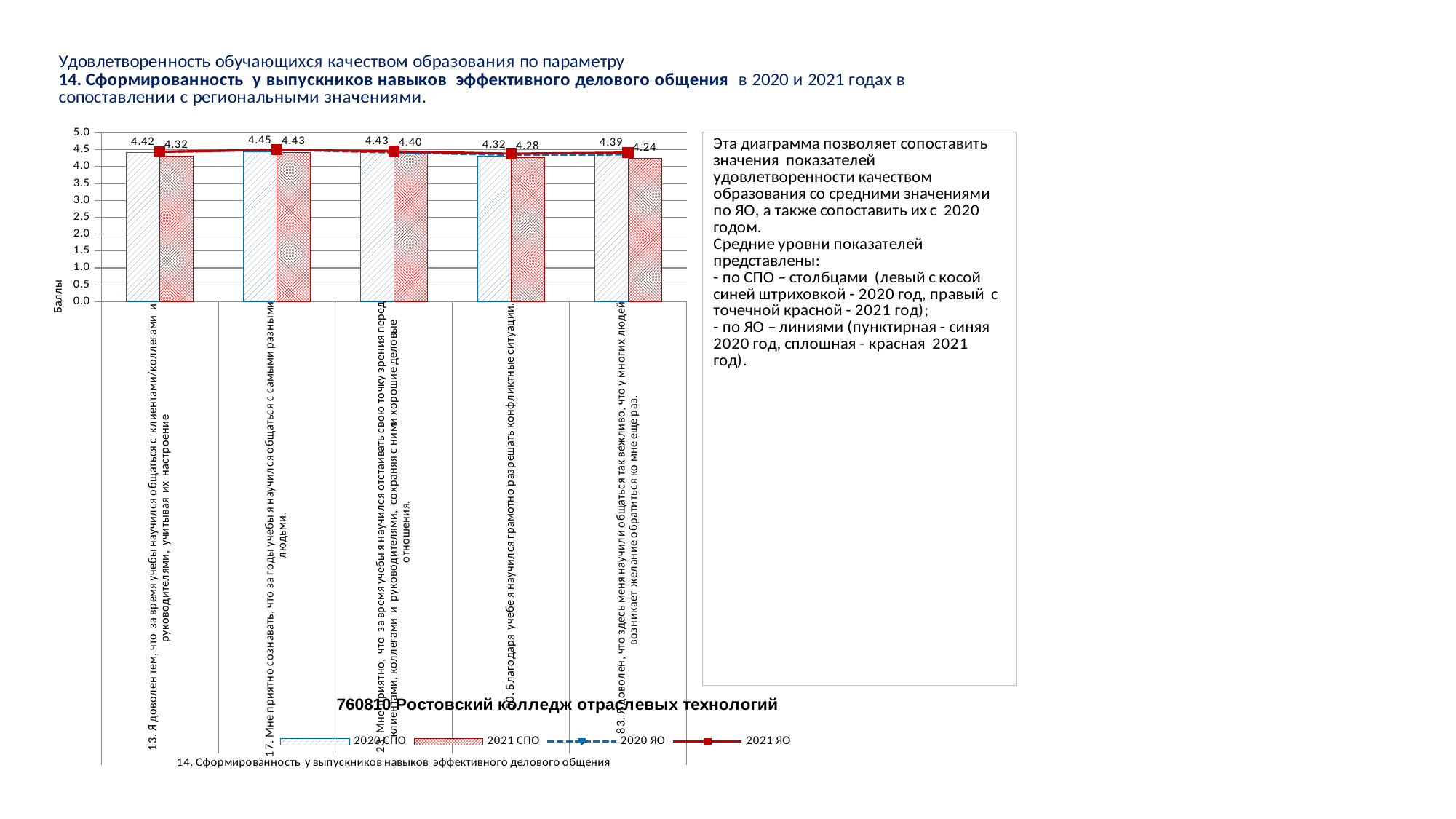
What is the 2021 СПО value for item 83 (Я доволен, что здесь меня научили общаться так вежливо)? 4.24 For item 13, which is larger: the 2020 СПО value or the 2021 СПО value? 2020 СПО Which item has the lowest 2021 СПО value? 83. Я доволен, что здесь меня научили общаться так вежливо, что у многих людей возникает желание обратиться ко мне еще раз How many series does the chart legend list? 4 What kind of chart is shown on the slide? Bar chart with lines What is the 2021 СПО value for item 50 (Благодаря учебе я научился грамотно разрешать конфликтные ситуации)? 4.28 What is the 2020 СПО value for item 13 (Я доволен тем, что за время учебы научился общаться с клиентами/коллегами и руководителями)? 4.42 What is the label of the vertical axis of the chart? Баллы What is the difference between the 2020 СПО and 2021 СПО values for item 83? 0.15 Which item has the highest 2020 СПО value? 17. Мне приятно сознавать, что за годы учебы я научился общаться с самыми разными людьми What is the difference between the 2020 СПО values for item 17 and item 50? 0.13 How many items (categories) are shown on the x axis of the chart? 5